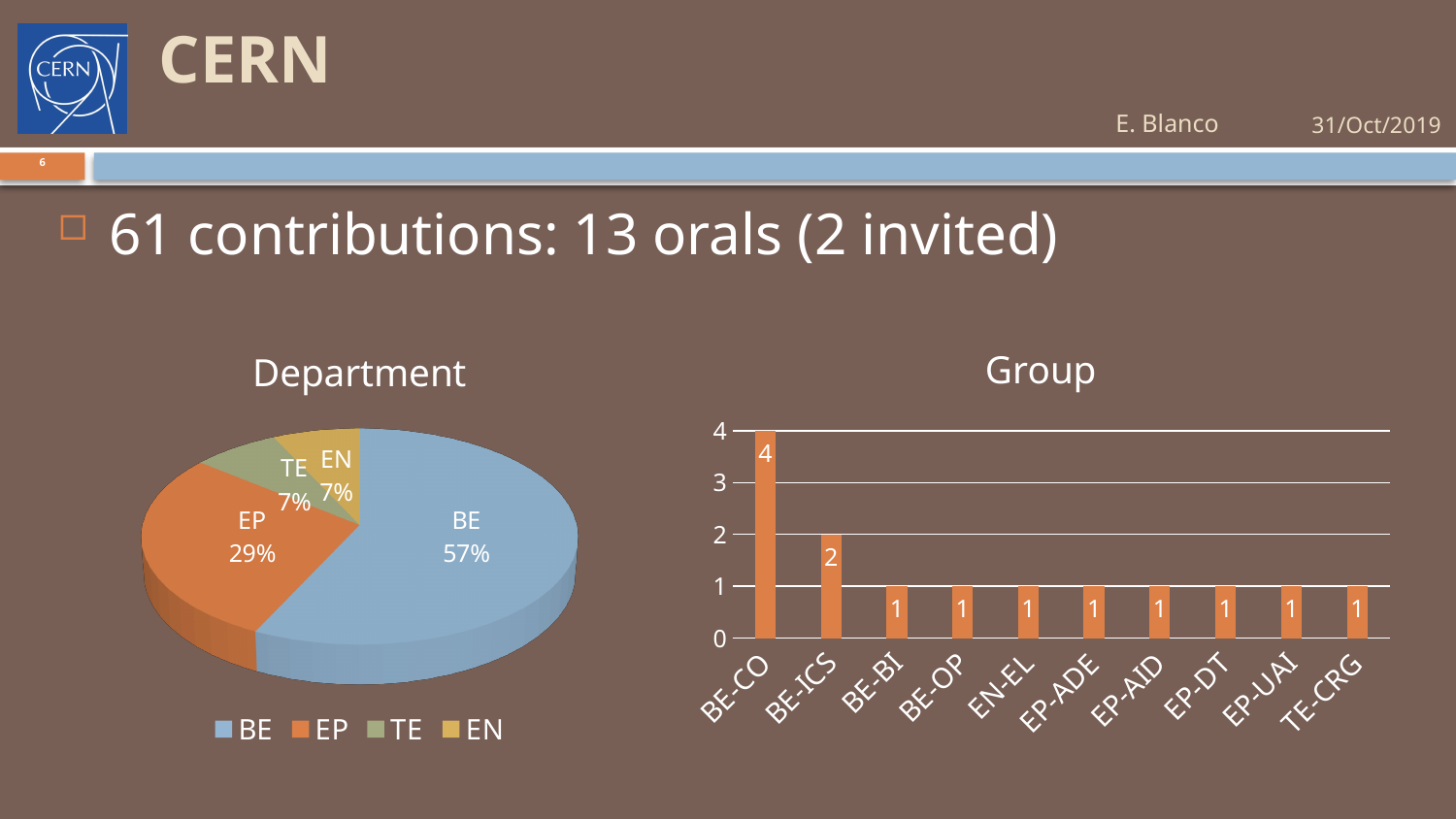
In the Department chart, what share of the pie does EP have? 29% In the Group chart, what is the value for BE-CO? 4 In the Department chart, what is the difference between the BE and EP shares? 28% In the Group chart, what is the difference between the values for BE-CO and BE-ICS? 2 What kind of chart is the Group chart? Bar chart In the Group chart, which group has the highest value? BE-CO In the Department chart, how many slices does the pie have? 4 In the Department chart, which department has the largest slice? BE In the Group chart, how many groups are shown on the x axis? 10 What kind of chart is the Department chart? Pie chart In the Department chart, what share of the pie does BE have? 57% In the Group chart, what is the value for BE-ICS? 2